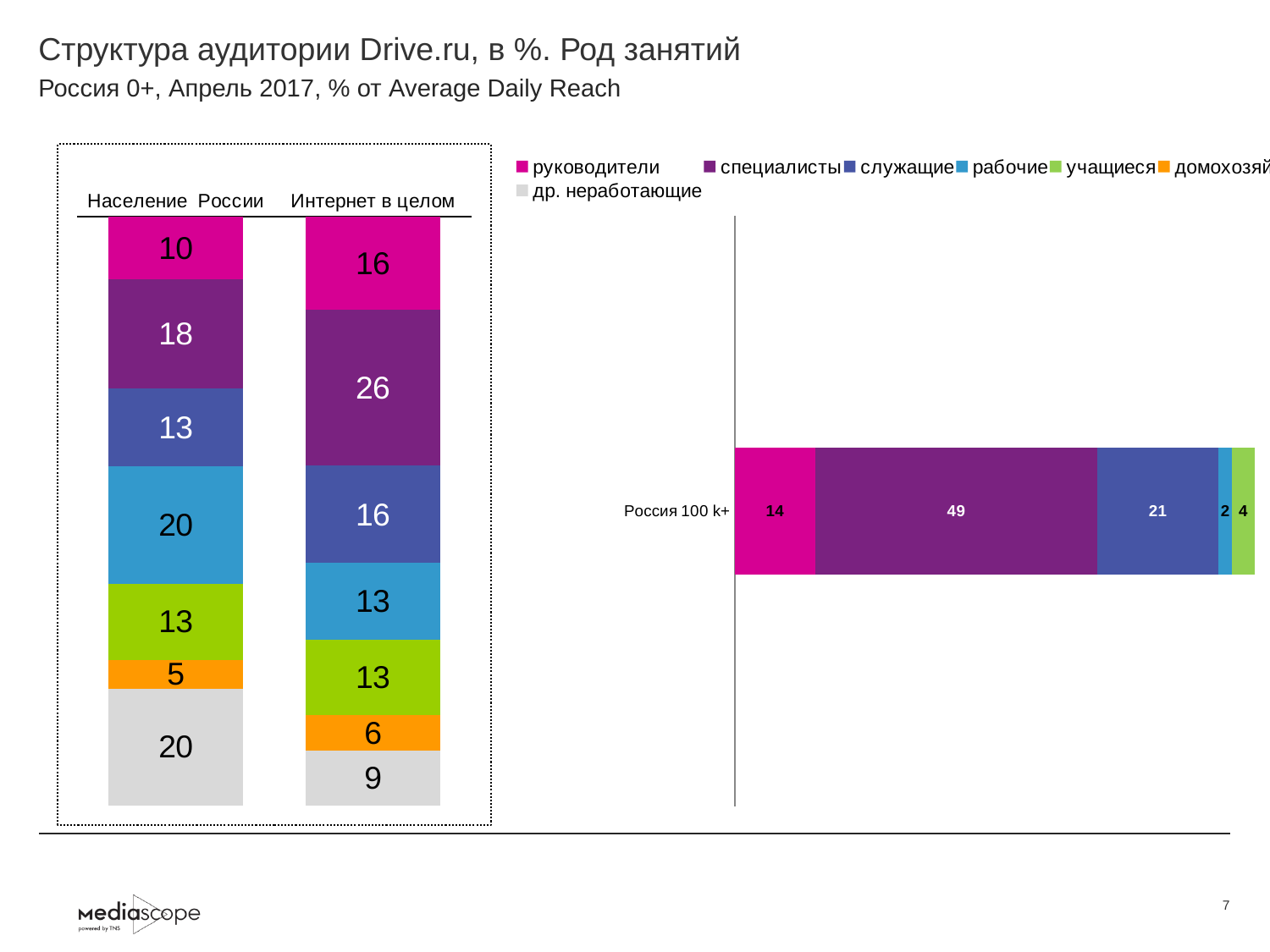
In the right chart, what is the difference between специалисты and руководители for Россия 100 k+? 35 In the right chart (Россия 100 k+), what is the value for специалисты? 49 In the left chart, what is the value for руководители in the Население России bar? 10 In the right chart (Россия 100 k+), what is the value for служащие? 21 In the left chart, what is the difference between специалисты in Интернет в целом and специалисты in Население России? 8 In the left chart, what is the value for др. неработающие in the Интернет в целом bar? 9 How many bars does the left chart show? 2 In the left chart, what is the value for специалисты in the Интернет в целом bar? 26 What type of chart is the right chart (Россия 100 k+)? Stacked bar chart In the left chart, which segment is the largest in the Интернет в целом bar? специалисты In the left chart, which is larger: рабочие in Население России or рабочие in Интернет в целом? Население России In the left chart, which segment is the smallest in the Население России bar? домохозяйки (5)